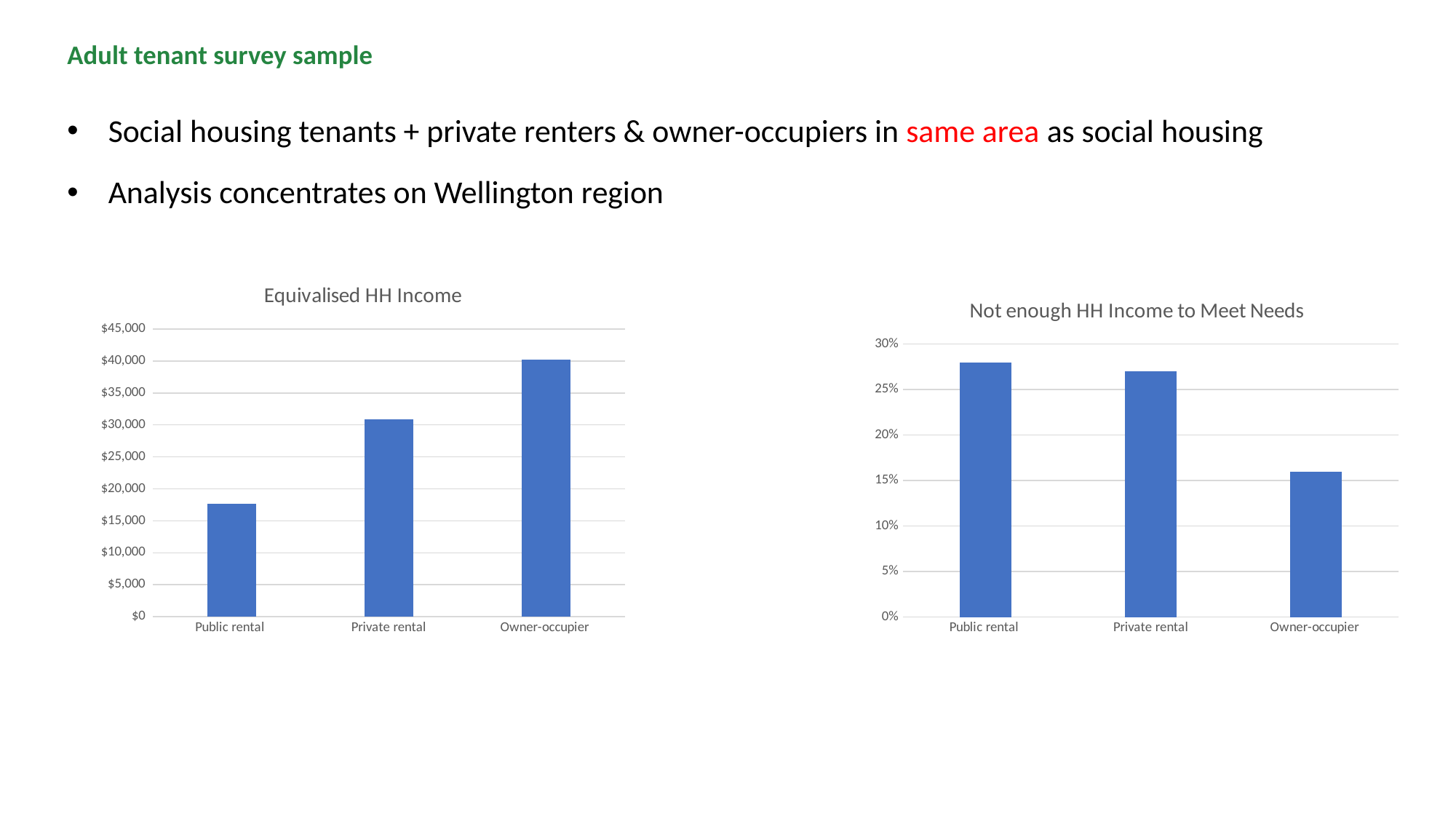
In the 'Not enough HH Income to Meet Needs' chart, is the value for Owner-occupier greater or less than 20%? less In the 'Equivalised HH Income' chart, do the values rise or fall from Public rental to Owner-occupier? Rise In the 'Equivalised HH Income' chart, which category has the highest value? Owner-occupier In the 'Equivalised HH Income' chart, which category has the lowest value? Public rental What is the title of the chart on the right side of the slide? Not enough HH Income to Meet Needs In the 'Equivalised HH Income' chart, how many categories are shown on the x axis? 3 In the 'Not enough HH Income to Meet Needs' chart, is the value for Public rental greater or less than 25%? greater In the 'Equivalised HH Income' chart, is the value for Public rental greater or less than $20,000? less In the 'Not enough HH Income to Meet Needs' chart, which is larger, the value for Private rental or the value for Owner-occupier? Private rental In the 'Equivalised HH Income' chart, what kind of chart is shown? Bar chart In the 'Not enough HH Income to Meet Needs' chart, which category has the lowest value? Owner-occupier